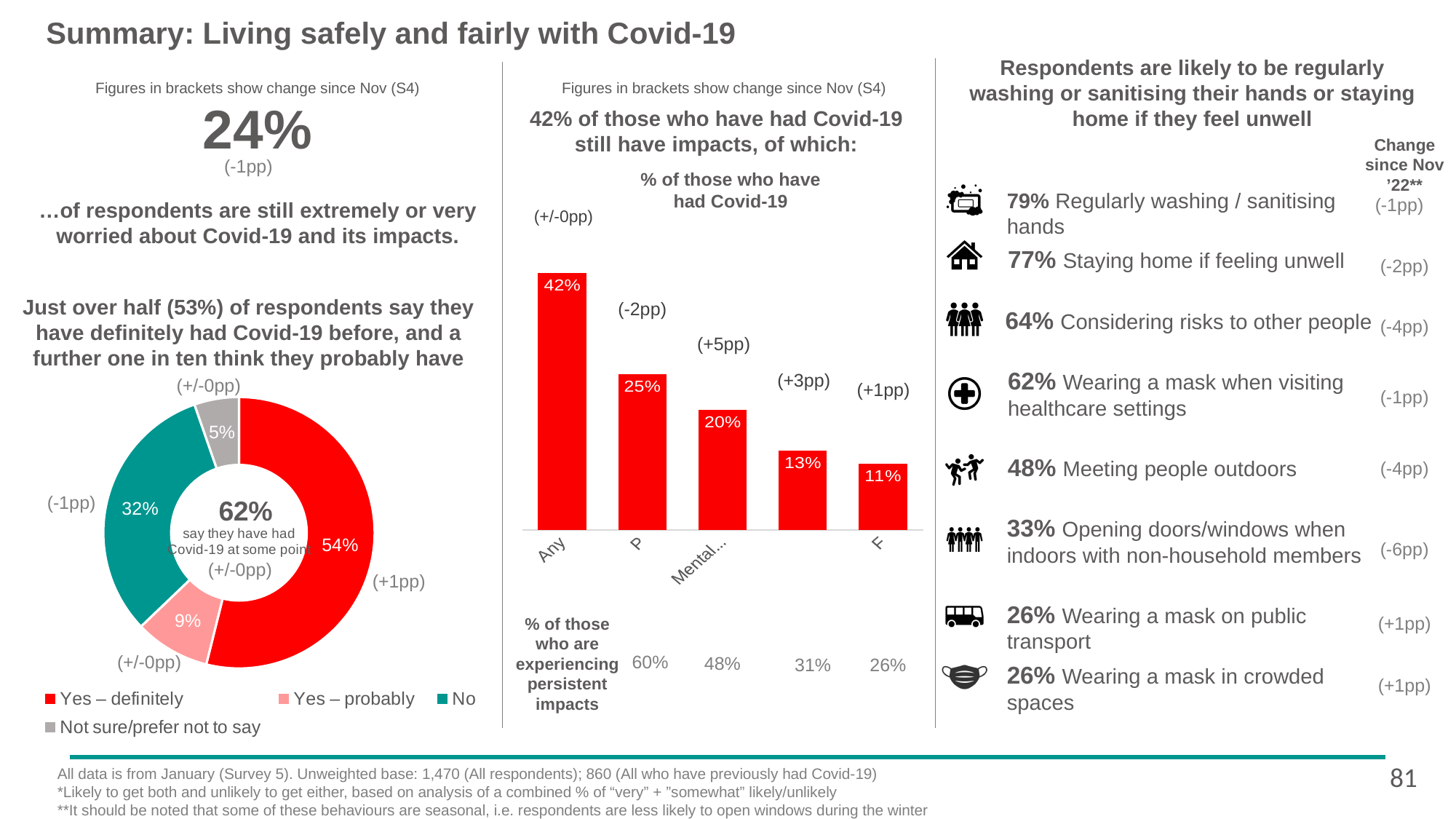
In the donut chart on the left, what share of respondents say 'Yes – definitely' they have had Covid-19? 54% In the bar chart in the middle, what is the difference between the first bar (42%) and the second bar (25%)? 17 percentage points How many categories does the legend of the donut chart on the left list? 4 In the bar chart in the middle, do the values rise or fall from left to right? Fall In the donut chart on the left, what is the difference between the 'Yes – definitely' share and the 'No' share? 22 percentage points In the donut chart on the left, what share of respondents answered 'Yes – probably'? 9% In the bar chart in the middle, how many bars are plotted? 5 In the bar chart in the middle, what is the value for 'Any'? 42% In the donut chart on the left, which category has the smallest share? Not sure/prefer not to say In the donut chart on the left, which category has the largest share? Yes – definitely In the donut chart on the left, what share of respondents answered 'No'? 32% What type of chart is the chart in the middle of the slide showing persistent impacts? Bar chart